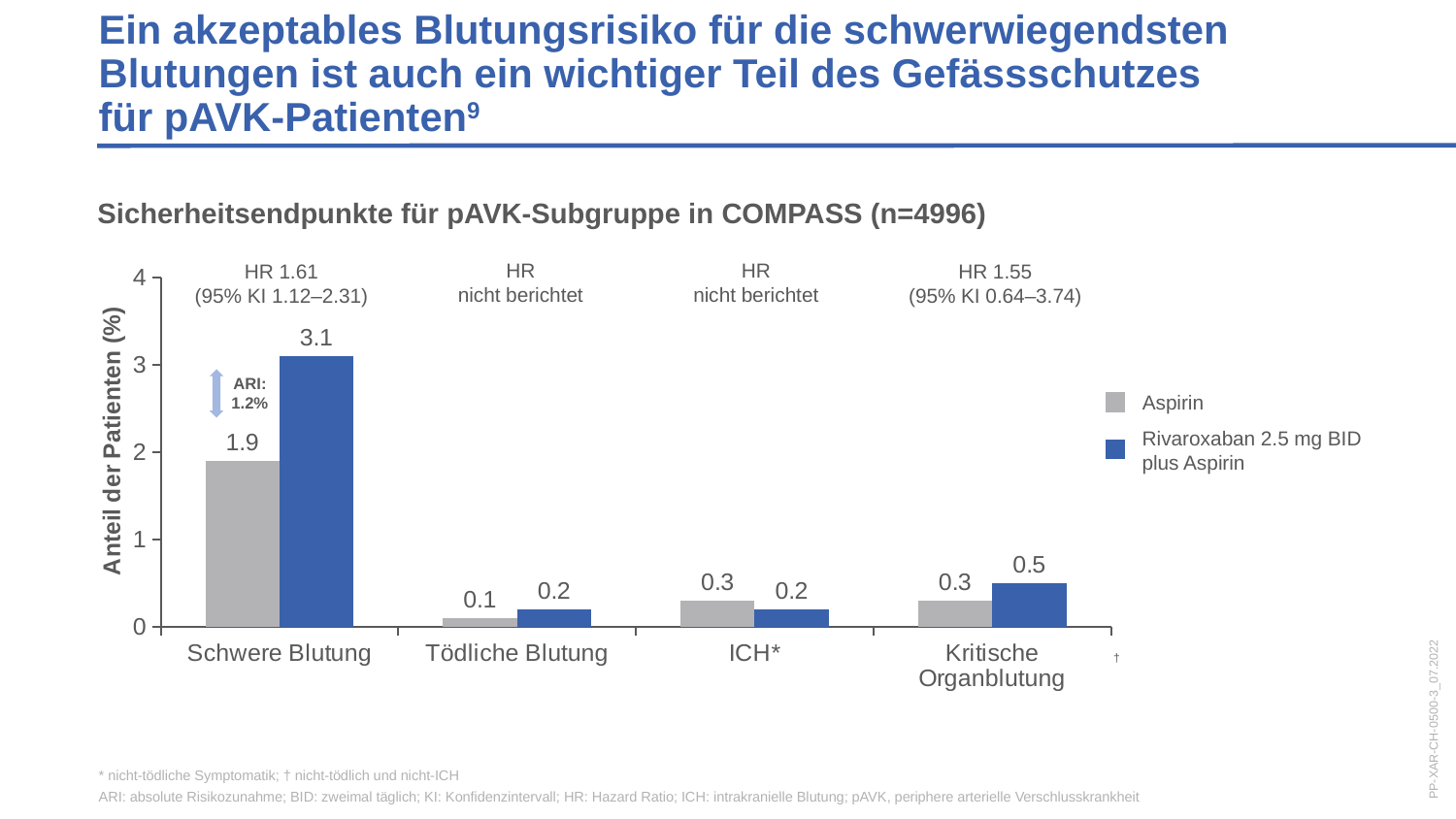
What is the label of the y axis? Anteil der Patienten (%) What is the value for Rivaroxaban 2.5 mg BID plus Aspirin in the Kritische Organblutung category? 0.5 How many series does the legend list? 2 How many categories are shown on the x axis? 4 In the ICH* category, which series has the larger value, Aspirin or Rivaroxaban 2.5 mg BID plus Aspirin? Aspirin What is the value for Aspirin in the Schwere Blutung category? 1.9 What is the difference between the Rivaroxaban 2.5 mg BID plus Aspirin and Aspirin values for Schwere Blutung? 1.2 What kind of chart is shown on the slide? Bar chart What is the value for Aspirin in the Tödliche Blutung category? 0.1 Which category has the lowest value for Aspirin? Tödliche Blutung Which category has the highest value for Rivaroxaban 2.5 mg BID plus Aspirin? Schwere Blutung What is the value for Rivaroxaban 2.5 mg BID plus Aspirin in the Schwere Blutung category? 3.1